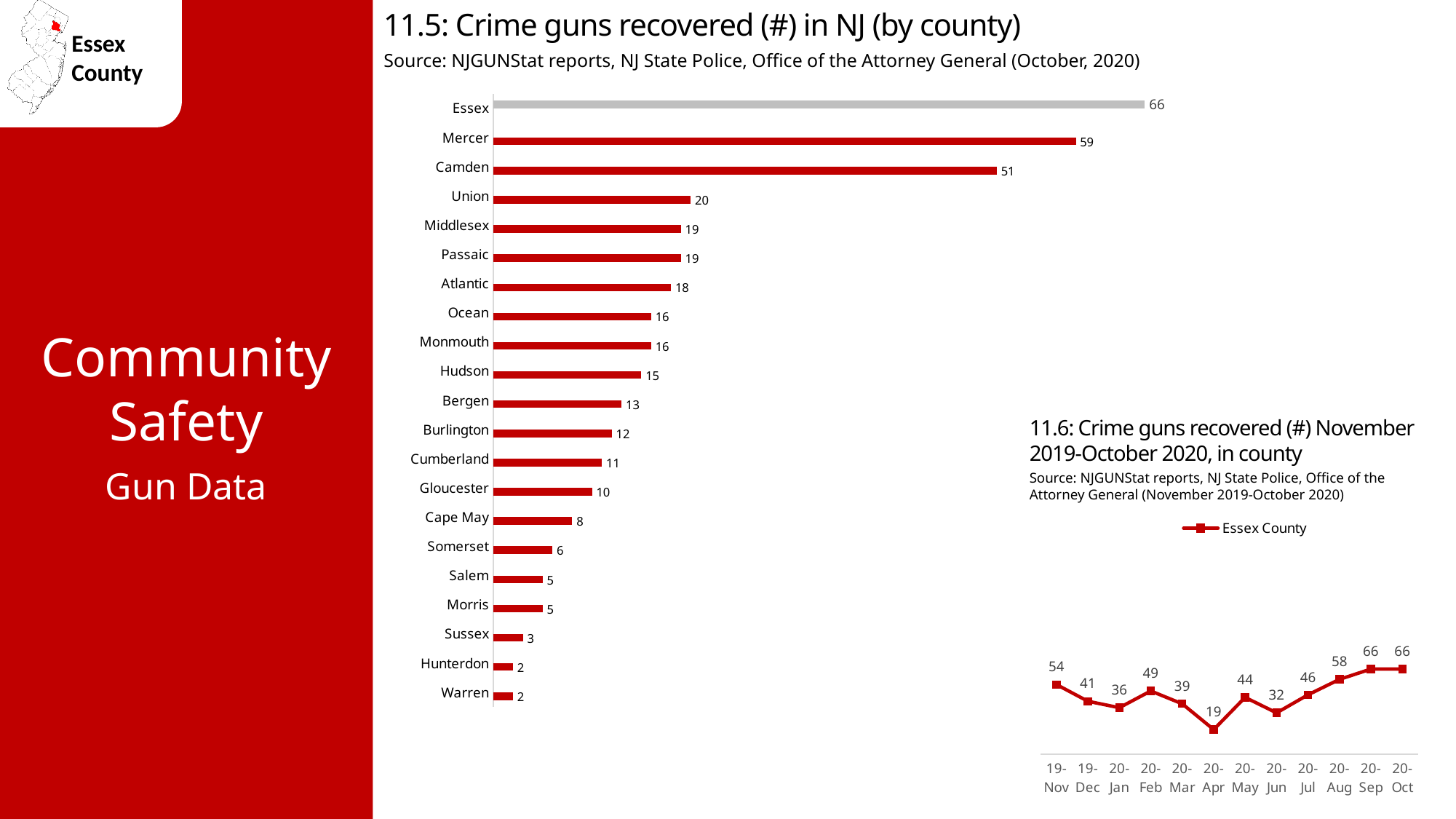
In chart 11.5 (Crime guns recovered in NJ by county), how many counties are shown? 21 In chart 11.6 (Crime guns recovered November 2019-October 2020 in county), what is the value for 20-Apr? 19 In chart 11.5 (Crime guns recovered in NJ by county), which is larger, Union or Hudson? Union In chart 11.6 (Crime guns recovered November 2019-October 2020 in county), do the values rise or fall from 20-Apr to 20-Oct? Rise In chart 11.6 (Crime guns recovered November 2019-October 2020 in county), which month has the lowest value? 20-Apr In chart 11.5 (Crime guns recovered in NJ by county), what is the value for Camden? 51 In chart 11.6 (Crime guns recovered November 2019-October 2020 in county), how many series does the legend list? 1 In chart 11.5 (Crime guns recovered in NJ by county), which county has the highest number of crime guns recovered? Essex In chart 11.5 (Crime guns recovered in NJ by county), what is the difference between Essex and Mercer? 7 What kind of chart is chart 11.5 (Crime guns recovered in NJ by county)? Bar chart In chart 11.6 (Crime guns recovered November 2019-October 2020 in county), what is the difference between 20-Oct and 19-Nov? 12 In chart 11.5 (Crime guns recovered in NJ by county), how many crime guns were recovered in Essex? 66